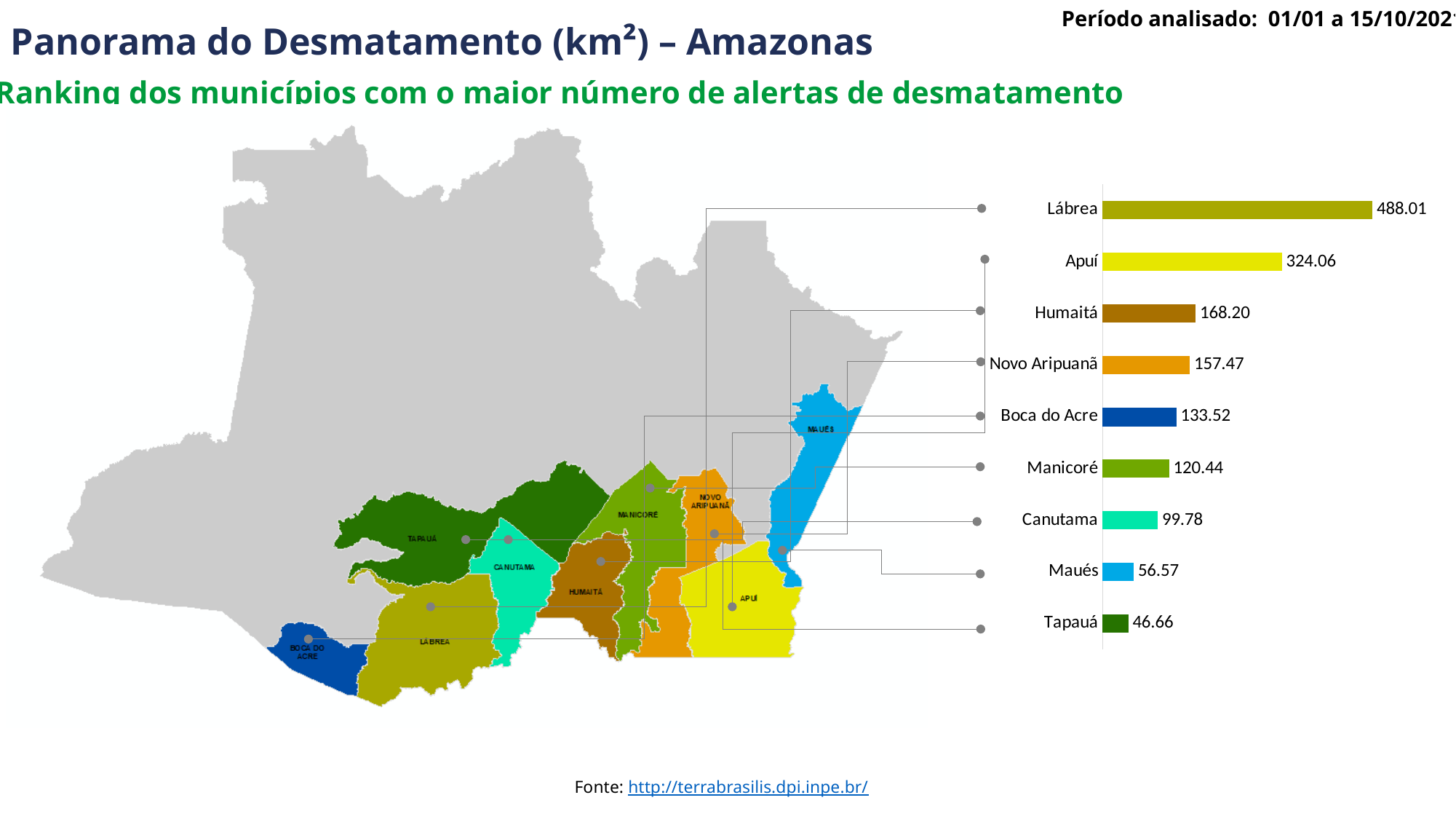
What is the value for Novo Aripuanã? 157.47 What colour is the bar for Maués? Light blue What is the value for Lábrea? 488.01 Which is larger, the value for Canutama or the value for Maués? Canutama What kind of chart is used to show the ranking of municipalities? Bar chart What is the difference between the values for Humaitá and Novo Aripuanã? 10.73 Which municipality has the lowest value? Tapauá How many municipalities are shown in the bar chart? 9 Which municipality has the highest value? Lábrea What is the value for Maués? 56.57 What is the difference between the values for Lábrea and Apuí? 163.95 Which is larger, the value for Boca do Acre or the value for Manicoré? Boca do Acre